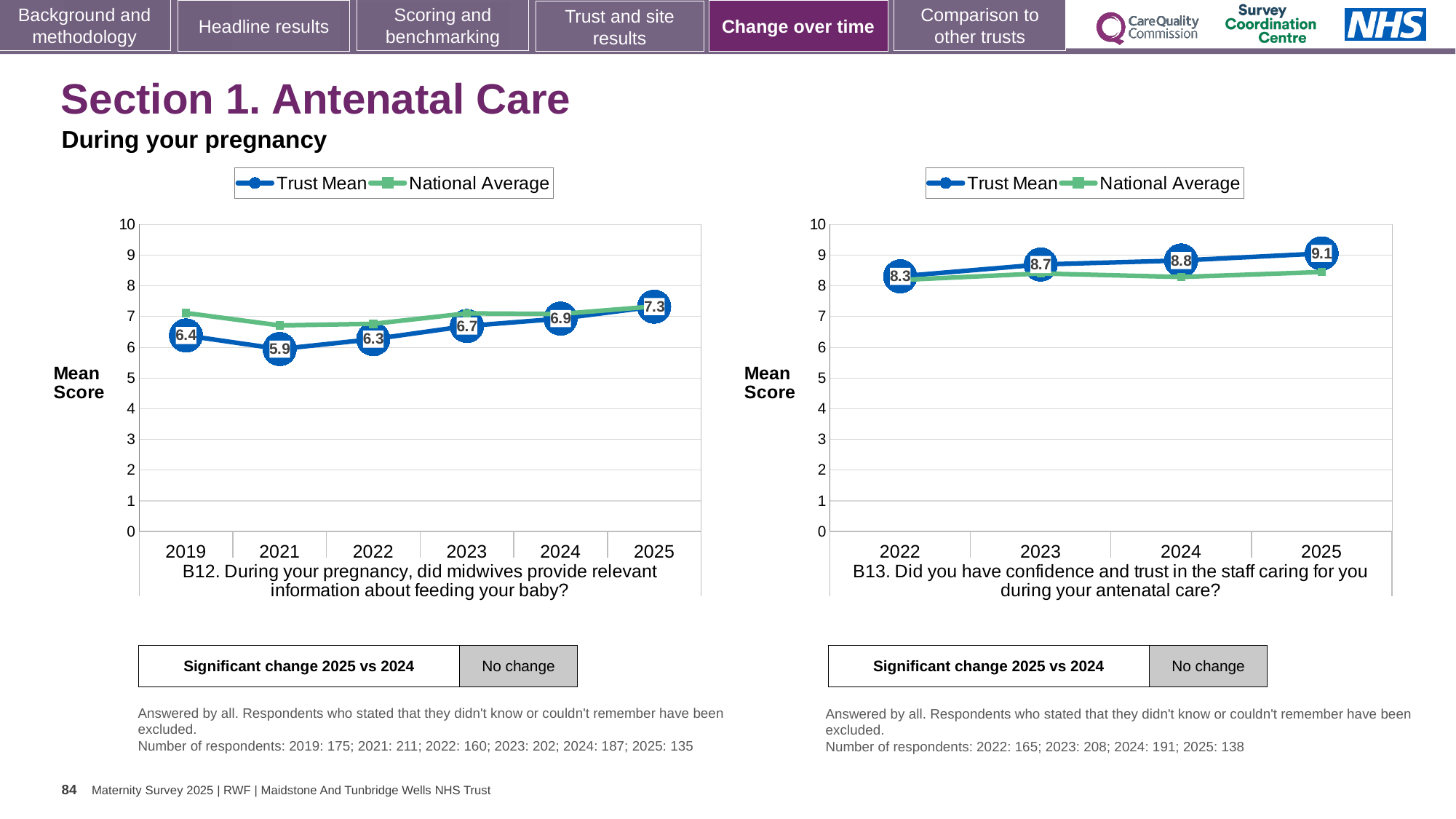
In the B12 chart, which is larger: the Trust Mean for 2023 or the Trust Mean for 2022? 2023 How many series does the legend of the B12 chart list? 2 In the B12 chart, what is the difference between the Trust Mean for 2025 and the Trust Mean for 2019? 0.9 In the B12 chart, what is the Trust Mean for 2021? 5.9 In the B13 chart, what is the difference between the Trust Mean for 2025 and the Trust Mean for 2022? 0.8 In the B13 chart, which year has the highest Trust Mean? 2025 What kind of chart is the B13 chart? Line chart In the B12 chart, what is the Trust Mean for 2025? 7.3 In the B12 chart, which year has the lowest Trust Mean? 2021 In the B13 chart, what is the Trust Mean for 2022? 8.3 In the B12 chart, is the National Average for 2019 greater or less than 6? greater How many years are plotted on the x axis of the B13 chart? 4